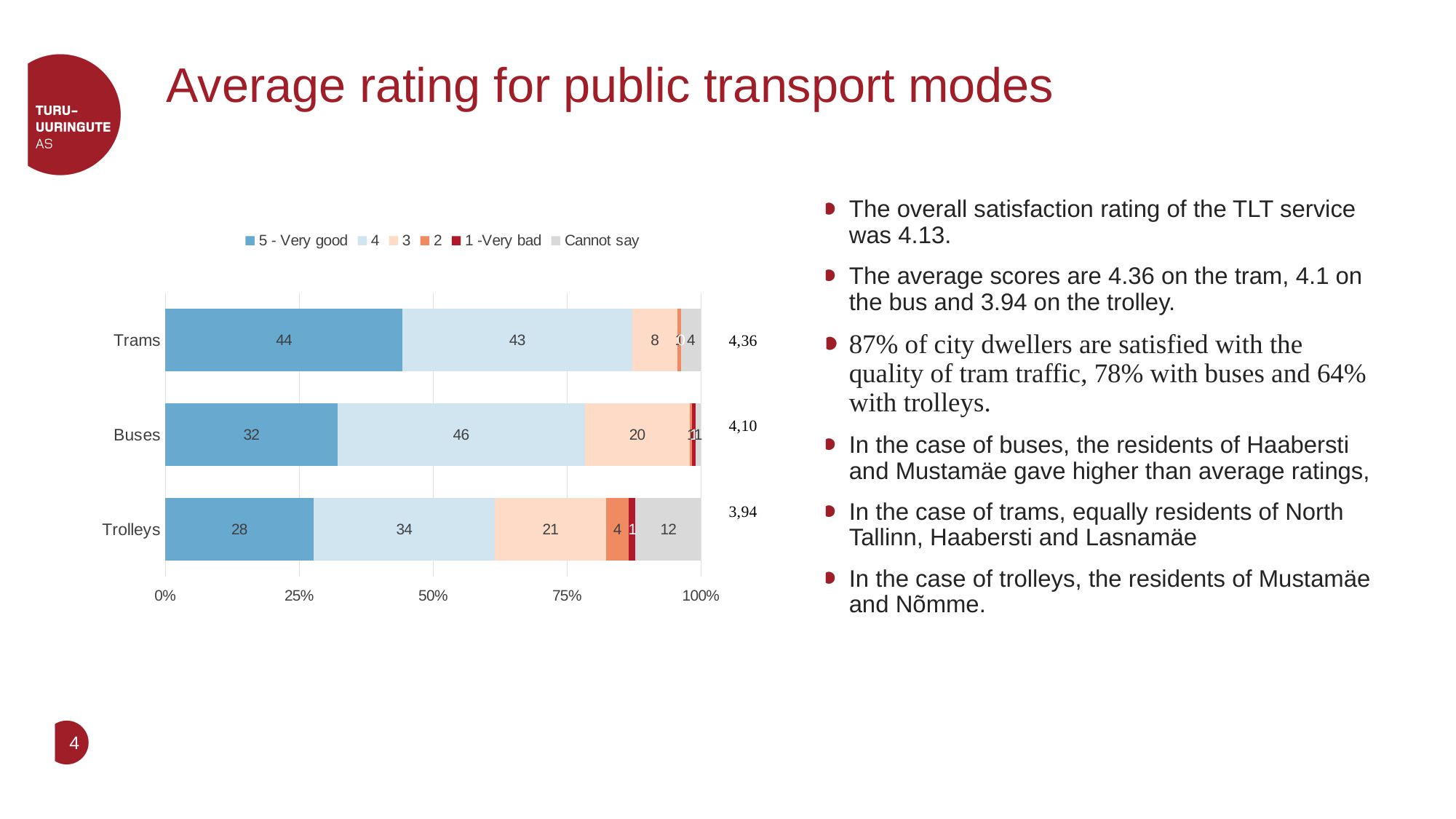
How many series does the chart legend list? 6 What is the '5 - Very good' value for Trams? 44 Which is larger, the '3' value for Buses or the '3' value for Trams? Buses Which transport mode has the highest '5 - Very good' value? Trams What kind of chart is shown on the slide? stacked bar chart What average rating is shown next to the Trolleys bar? 3,94 What is the '4' value for Buses? 46 What is the '3' value for Trolleys? 21 Which transport mode has the lowest '5 - Very good' value? Trolleys What is the difference between the '5 - Very good' values for Trams and Buses? 12 What is the 'Cannot say' value for Trolleys? 12 How many transport modes are shown on the chart? 3